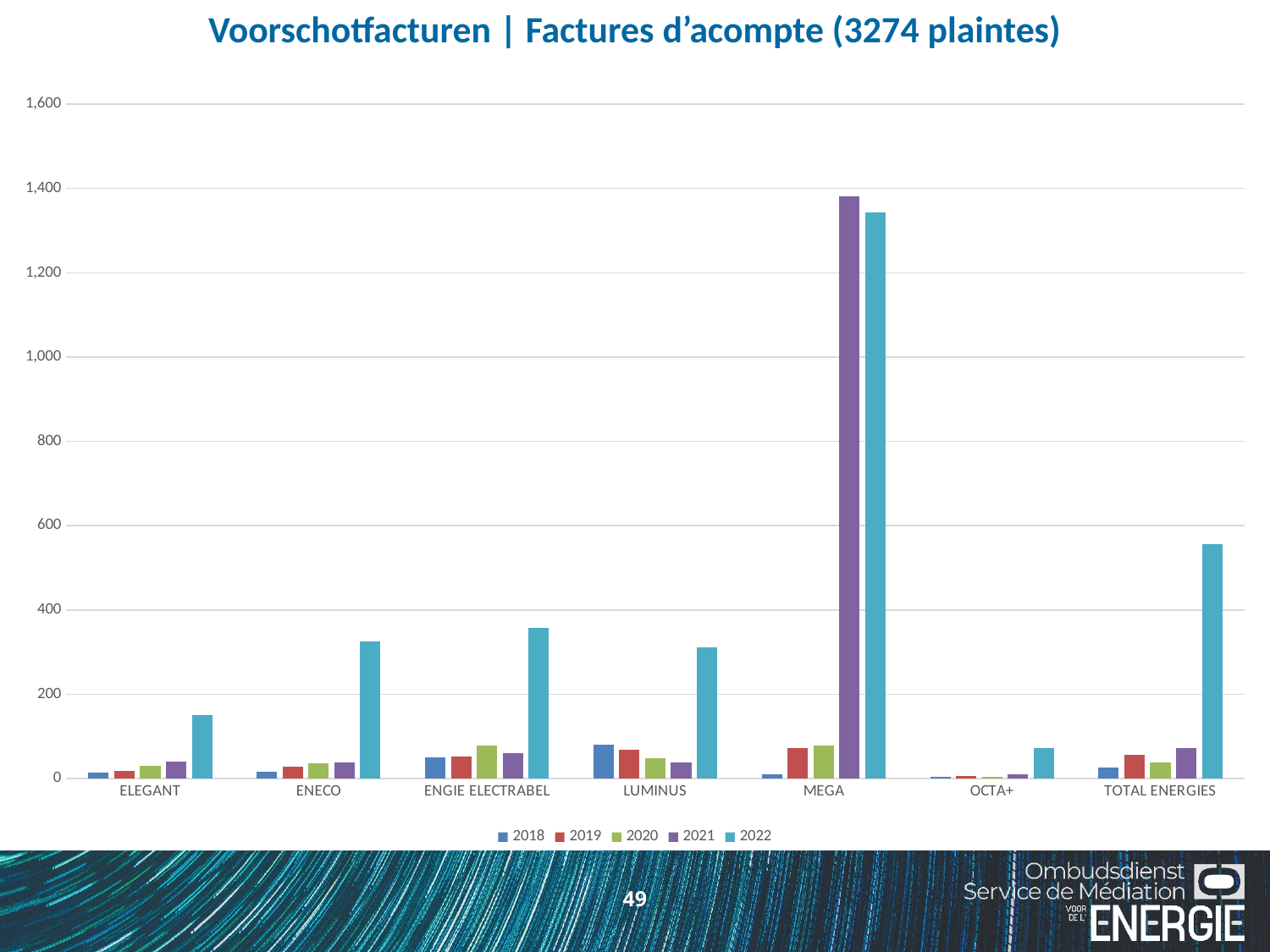
Do the values for ELEGANT rise or fall from 2018 to 2022? rise Is the 2022 value for TOTAL ENERGIES greater or less than 400? greater Is the 2021 value for MEGA greater or less than 1,200? greater Which supplier has the highest value for 2022? MEGA Is the 2022 value for ENECO greater or less than 200? greater How many series does the legend list? 5 How many supplier categories are shown on the x axis? 7 Which supplier has the lowest value for 2022? OCTA+ What is the title of the chart? Voorschotfacturen | Factures d'acompte (3274 plaintes) What kind of chart is shown on the slide? Bar chart Which is larger, the 2022 value for ENGIE ELECTRABEL or the 2022 value for ELEGANT? ENGIE ELECTRABEL